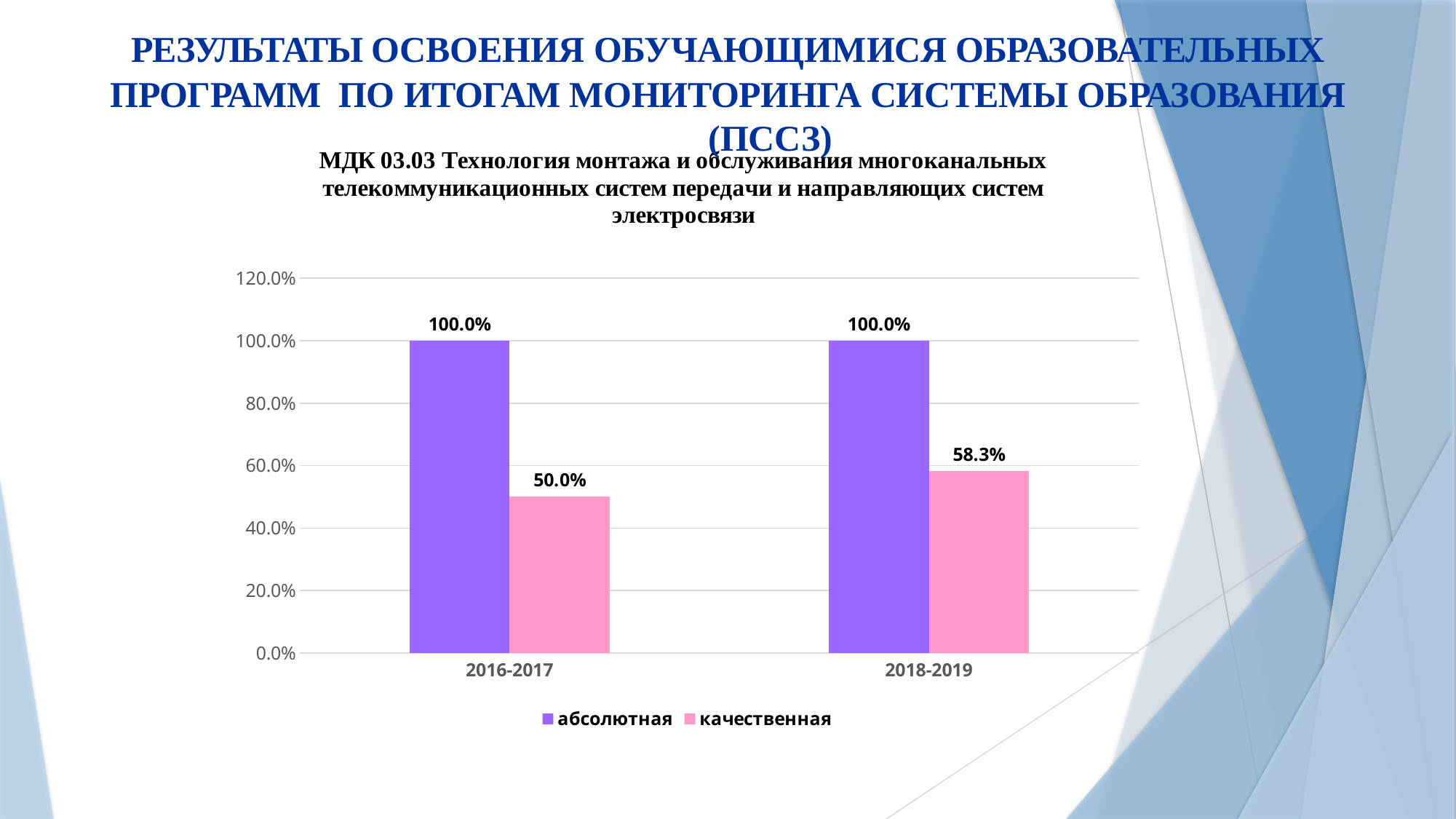
What is the difference between the абсолютная and качественная values for 2016-2017? 50.0% What is the value of the качественная series for 2016-2017? 50.0% How many year categories are shown on the x axis? 2 What kind of chart is shown on the slide? bar chart In which year is the качественная value lowest? 2016-2017 What is the value of the абсолютная series for 2018-2019? 100.0% In which year is the качественная value highest? 2018-2019 What is the difference between the качественная values for 2018-2019 and 2016-2017? 8.3% What is the value of the абсолютная series for 2016-2017? 100.0% What is the value of the качественная series for 2018-2019? 58.3% How many series does the legend list? 2 Which is larger for 2018-2019: абсолютная or качественная? абсолютная